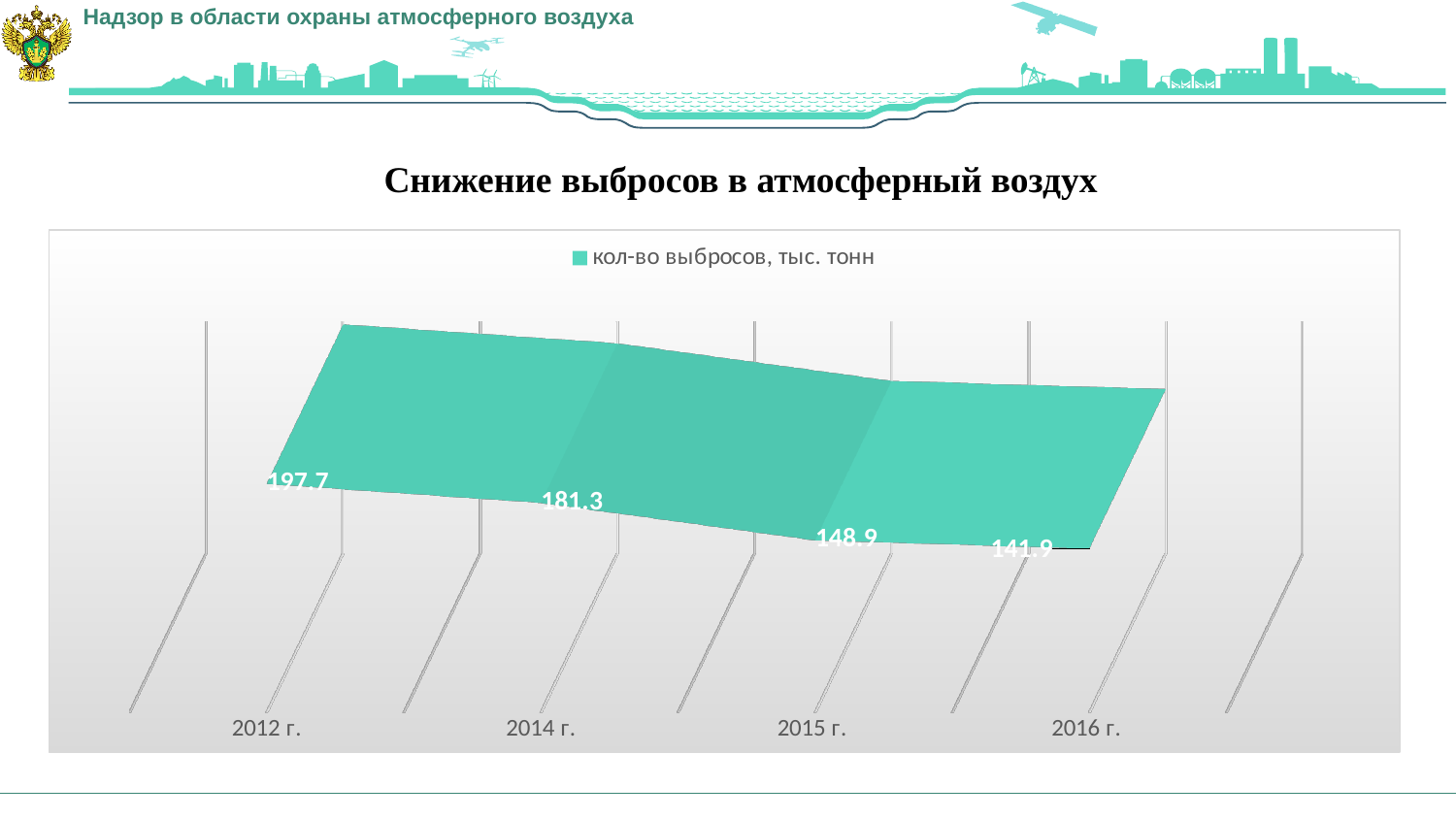
How many years are shown on the x axis? 4 Which is larger, the value for 2014 г. or the value for 2015 г.? 2014 г. Do the values rise or fall from 2012 г. to 2016 г.? fall What is the value for 2016 г.? 141.9 What is the difference between the values for 2014 г. and 2015 г.? 32.4 What is the value for 2015 г.? 148.9 What is the legend entry of the series shown? кол-во выбросов, тыс. тонн What is the value for 2014 г.? 181.3 Which year has the highest value? 2012 г. Which year has the lowest value? 2016 г. What is the difference between the values for 2012 г. and 2016 г.? 55.8 What is the value for 2012 г.? 197.7